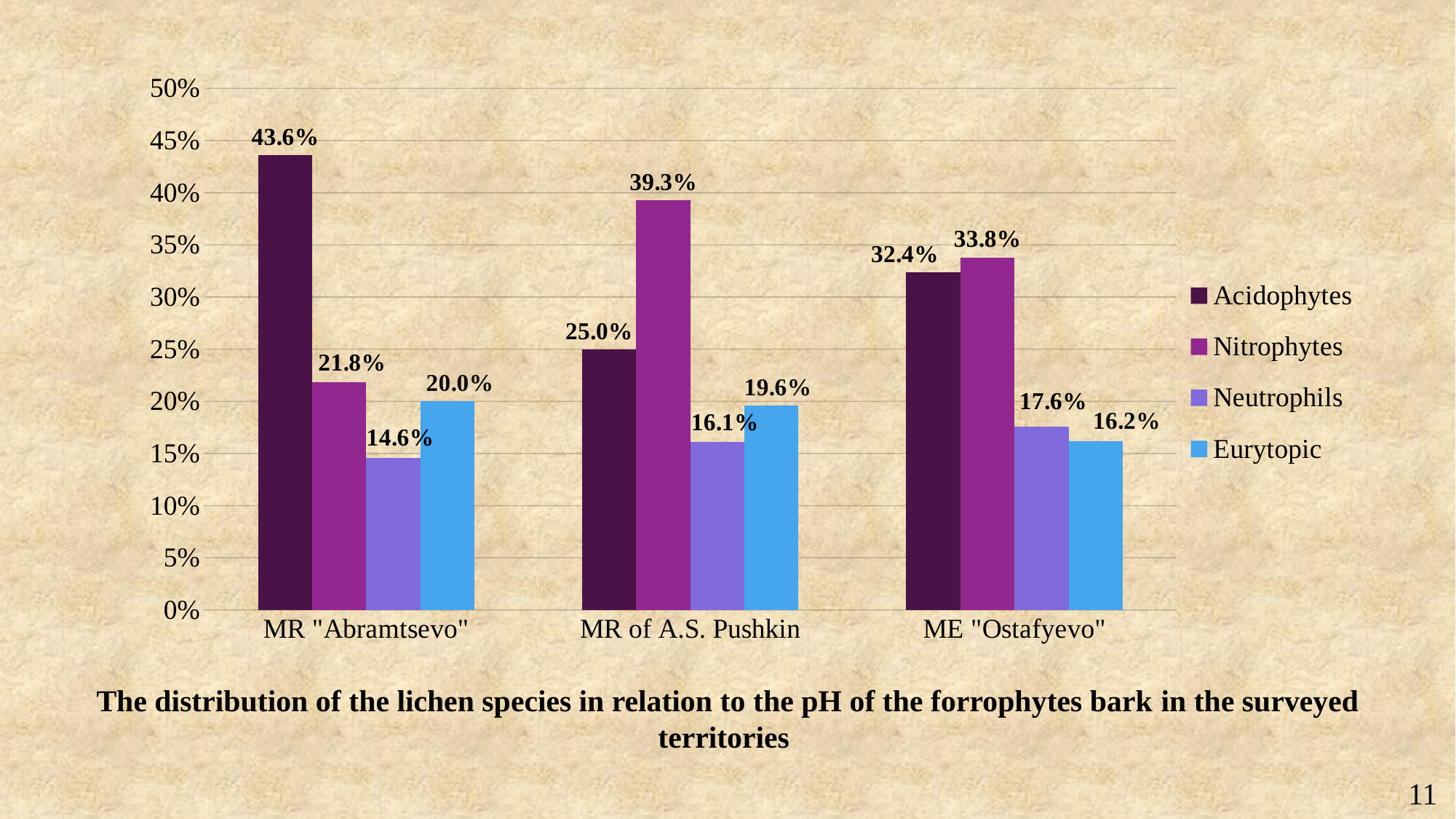
Which territory has the lowest value for Neutrophils? MR "Abramtsevo" What is the value for Nitrophytes at MR of A.S. Pushkin? 39.3% What is the value for Eurytopic at MR "Abramtsevo"? 20.0% What is the difference between the Acidophytes and Nitrophytes values at MR "Abramtsevo"? 21.8% How many series does the legend list? 4 Which is larger at ME "Ostafyevo": Acidophytes or Nitrophytes? Nitrophytes What is the value for Neutrophils at ME "Ostafyevo"? 17.6% What is the value for Acidophytes at MR "Abramtsevo"? 43.6% How many territories are shown on the x axis? 3 Which territory has the highest value for Acidophytes? MR "Abramtsevo" Is the value for Nitrophytes at MR of A.S. Pushkin greater or less than 35%? greater What kind of chart is shown on the slide? Bar chart